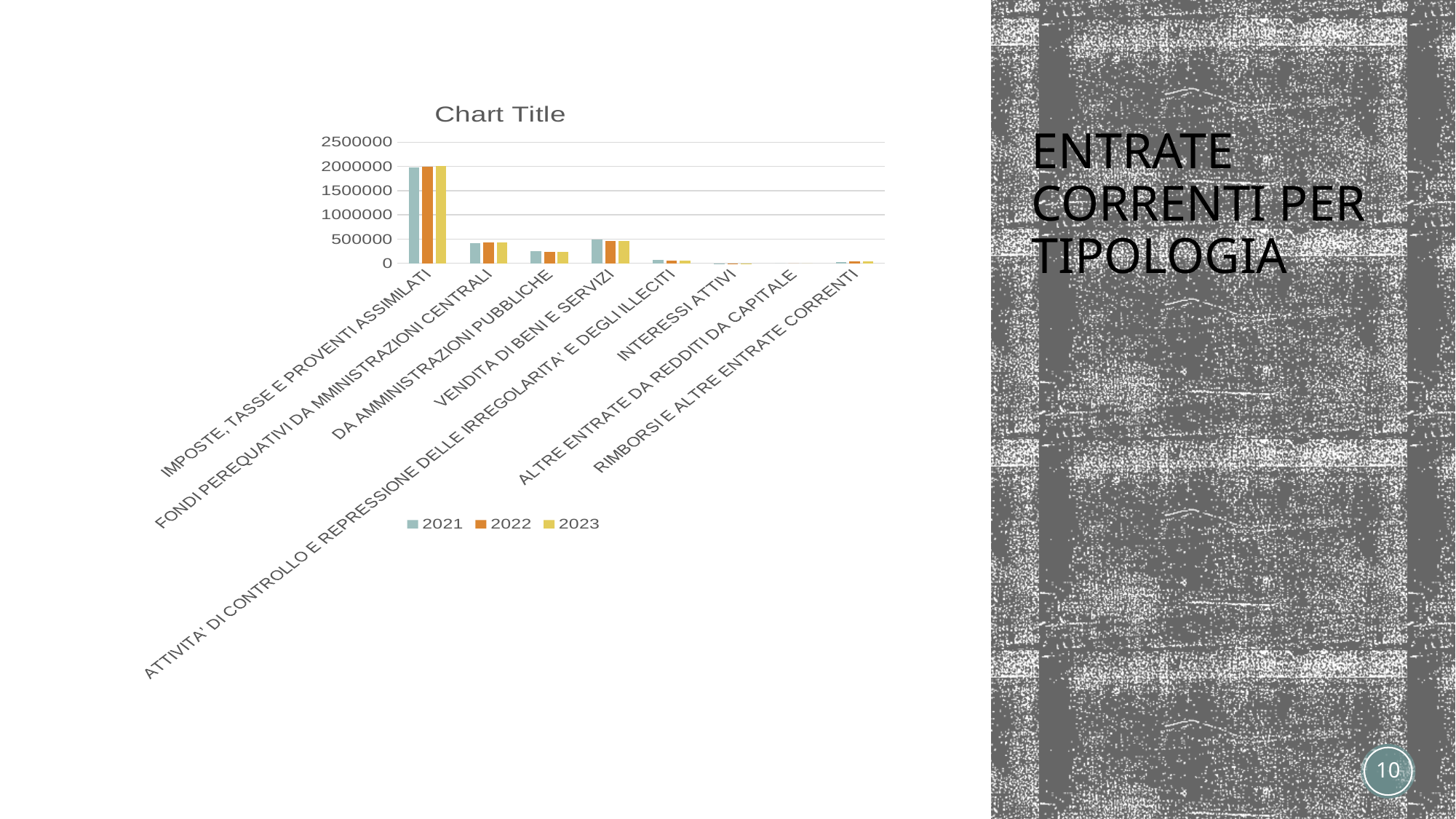
How many series does the chart's legend list? 3 Is the 2023 value for DA AMMINISTRAZIONI PUBBLICHE greater or less than 500000? less Is the 2021 value for IMPOSTE, TASSE E PROVENTI ASSIMILATI greater or less than 1500000? greater What kind of chart is shown on the slide? bar chart Which category has the highest values in the chart? IMPOSTE, TASSE E PROVENTI ASSIMILATI How many categories are shown on the x axis of the chart? 8 Is the 2022 value for FONDI PEREQUATIVI DA MMINISTRAZIONI CENTRALI greater or less than 500000? less What is the title shown above the chart? Chart Title Which years are listed in the chart's legend? 2021, 2022, 2023 Which category has the larger 2021 value: FONDI PEREQUATIVI DA MMINISTRAZIONI CENTRALI or DA AMMINISTRAZIONI PUBBLICHE? FONDI PEREQUATIVI DA MMINISTRAZIONI CENTRALI Which category has the larger 2022 value: IMPOSTE, TASSE E PROVENTI ASSIMILATI or VENDITA DI BENI E SERVIZI? IMPOSTE, TASSE E PROVENTI ASSIMILATI